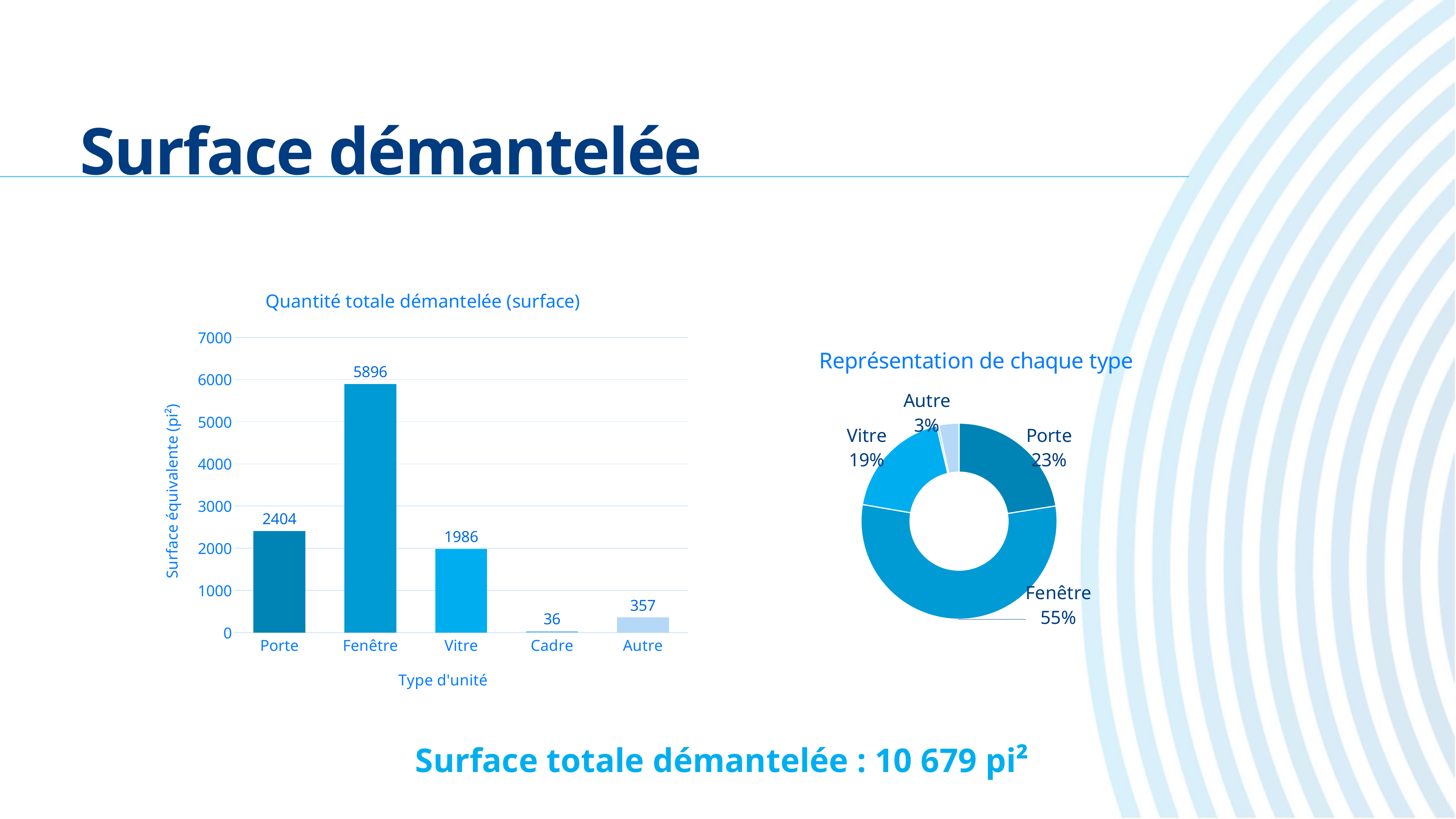
In the chart 'Quantité totale démantelée (surface)', which category has the lowest value? Cadre In the chart 'Quantité totale démantelée (surface)', what is the difference between the values for Porte and Vitre? 418 In the chart 'Représentation de chaque type', what share does Vitre have? 19% In the chart 'Quantité totale démantelée (surface)', what is the value for Fenêtre? 5896 In the chart 'Quantité totale démantelée (surface)', how many categories are shown on the x axis? 5 In the chart 'Quantité totale démantelée (surface)', which is larger, the value for Autre or the value for Cadre? Autre In the chart 'Quantité totale démantelée (surface)', what is the value for Cadre? 36 In the chart 'Représentation de chaque type', what share does Fenêtre have? 55% In the chart 'Représentation de chaque type', which slice is the smallest? Autre In the chart 'Quantité totale démantelée (surface)', which category has the highest value? Fenêtre What kind of chart is 'Quantité totale démantelée (surface)'? bar chart What is the y-axis title of the chart 'Quantité totale démantelée (surface)'? Surface équivalente (pi²)